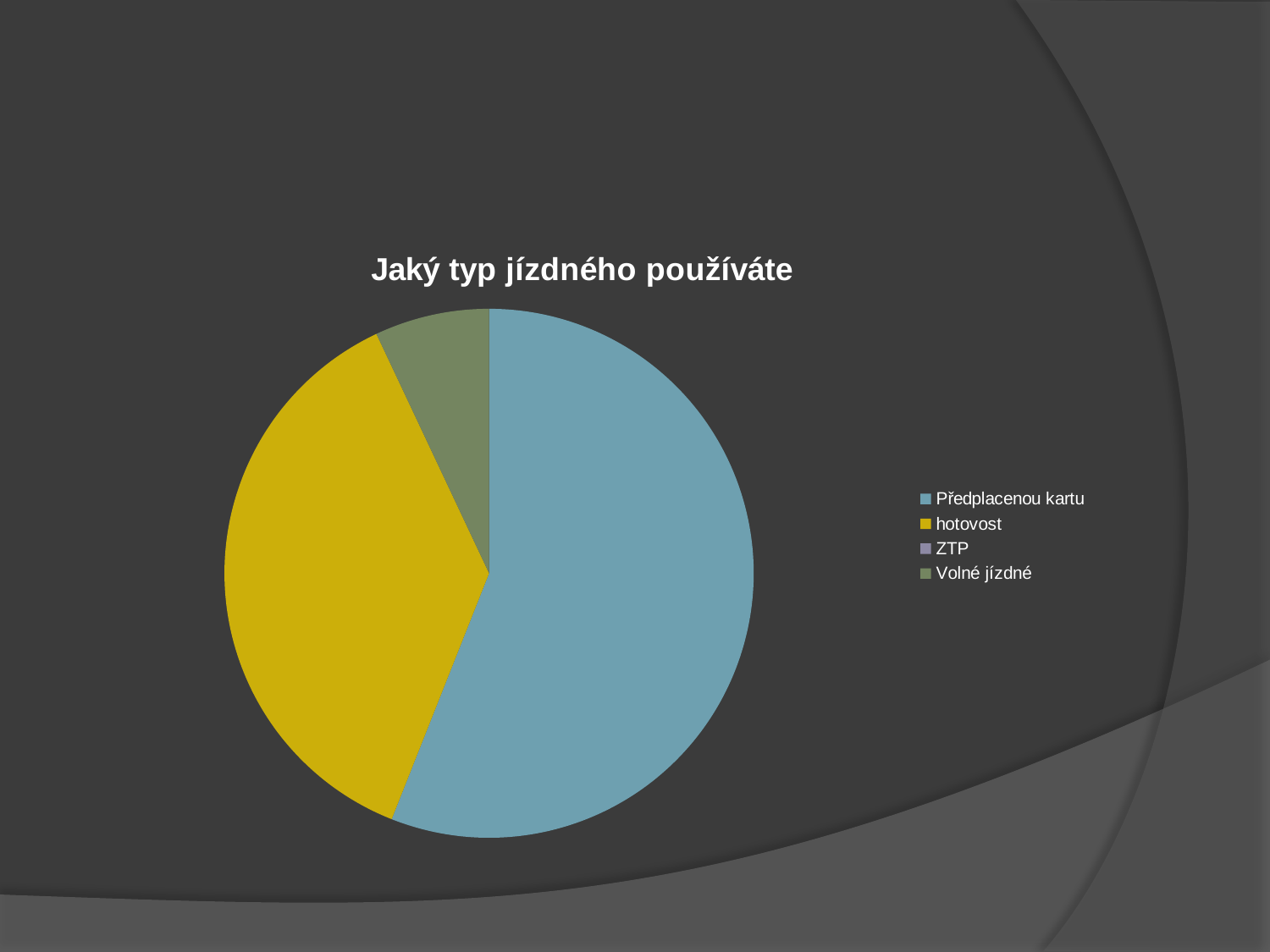
Which slice is larger, hotovost or Volné jízdné? hotovost Which category has the largest slice of the pie? Předplacenou kartu How many categories does the legend of the pie chart list? 4 Is the share of Předplacenou kartu greater or less than 50% of the pie? greater What kind of chart is shown on the slide? pie chart What colour is the hotovost slice in the pie chart? yellow Is the share of Volné jízdné greater or less than 25% of the pie? less Which slice is larger, Předplacenou kartu or hotovost? Předplacenou kartu What is the title of the chart? Jaký typ jízdného používáte Which slice is larger, Předplacenou kartu or Volné jízdné? Předplacenou kartu